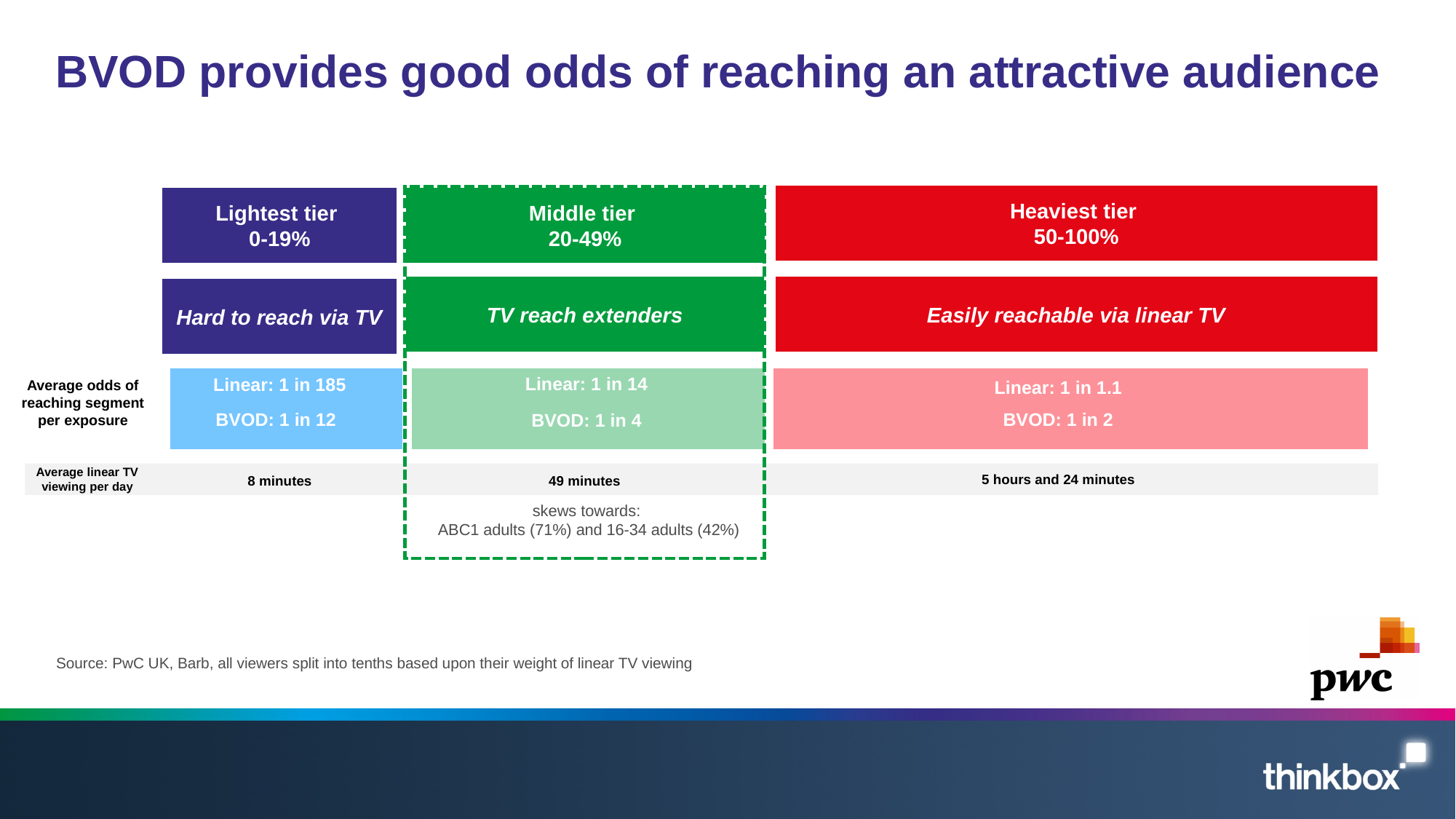
How many tiers does the diagram show? 3 In the diagram, what colour is used for the Heaviest tier? Red In the diagram, which tier is described as 'Hard to reach via TV'? Lightest tier In the diagram, what are the average odds of reaching the Middle tier segment per exposure via BVOD? 1 in 4 In the diagram, what are the average odds of reaching the Middle tier segment per exposure via Linear? 1 in 14 In the diagram, what is the average linear TV viewing per day for the Lightest tier? 8 minutes In the diagram, what are the average odds of reaching the Heaviest tier segment per exposure via BVOD? 1 in 2 In the diagram, what is the average linear TV viewing per day for the Heaviest tier? 5 hours and 24 minutes In the diagram, what are the average odds of reaching the Lightest tier segment per exposure via Linear? 1 in 185 In the diagram, what percentage range defines the Middle tier? 20-49% In the diagram, what is the average linear TV viewing per day for the Middle tier? 49 minutes In the diagram, what are the average odds of reaching the Lightest tier segment per exposure via BVOD? 1 in 12